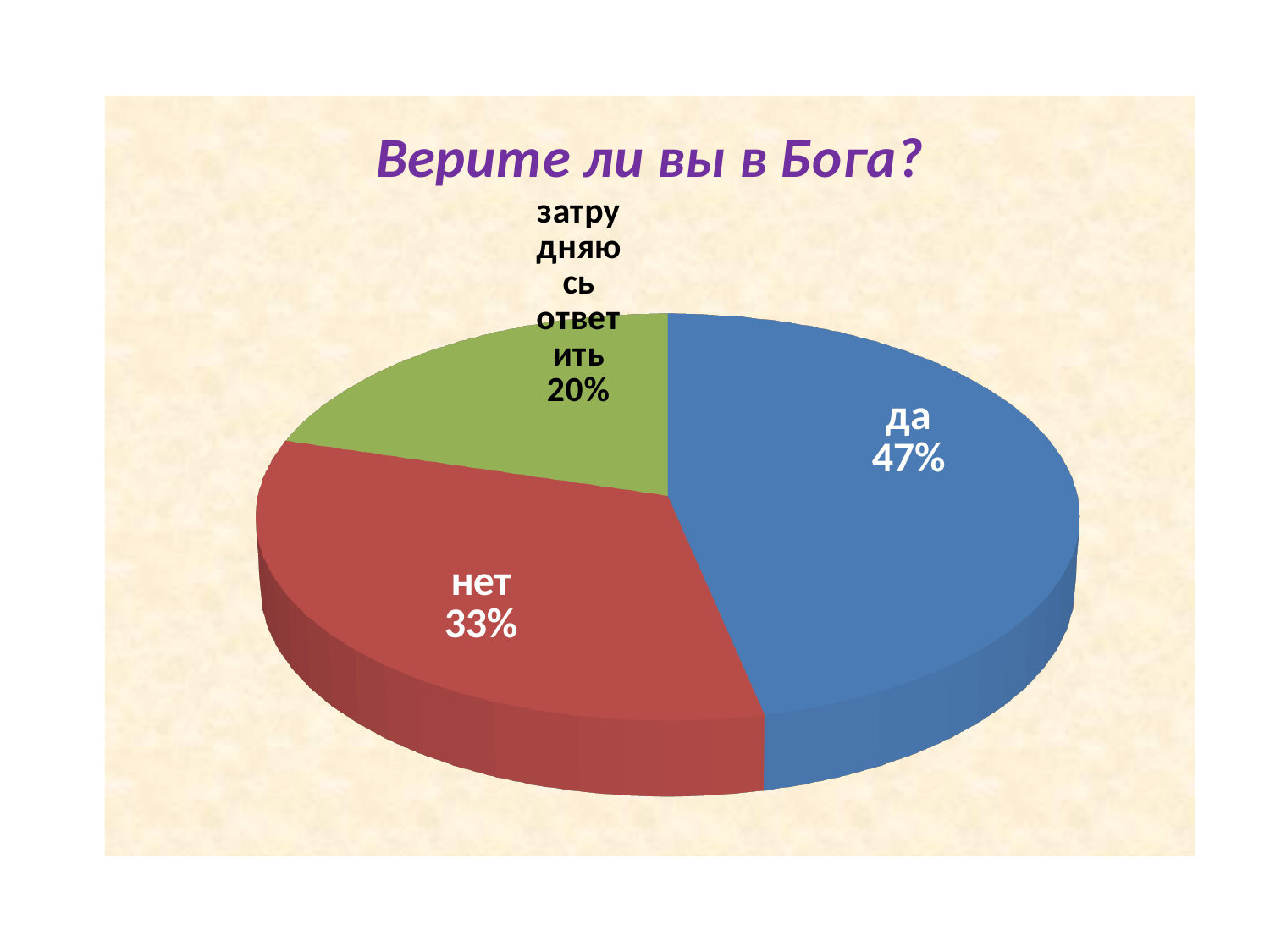
How many slices does the pie chart have? 3 What percentage of respondents answered "нет"? 33% Which is larger, the share for "нет" or the share for "затрудняюсь ответить"? нет What is the difference in percentage points between "да" and "нет"? 14 Which answer has the smallest share of the pie? затрудняюсь ответить What kind of chart is shown on the slide? pie chart What colour is the slice for "да"? blue What is the title of the chart? Верите ли вы в Бога? What is the difference in percentage points between "нет" and "затрудняюсь ответить"? 13 What percentage of respondents answered "затрудняюсь ответить"? 20% Which answer has the largest share of the pie? да What percentage of respondents answered "да"? 47%